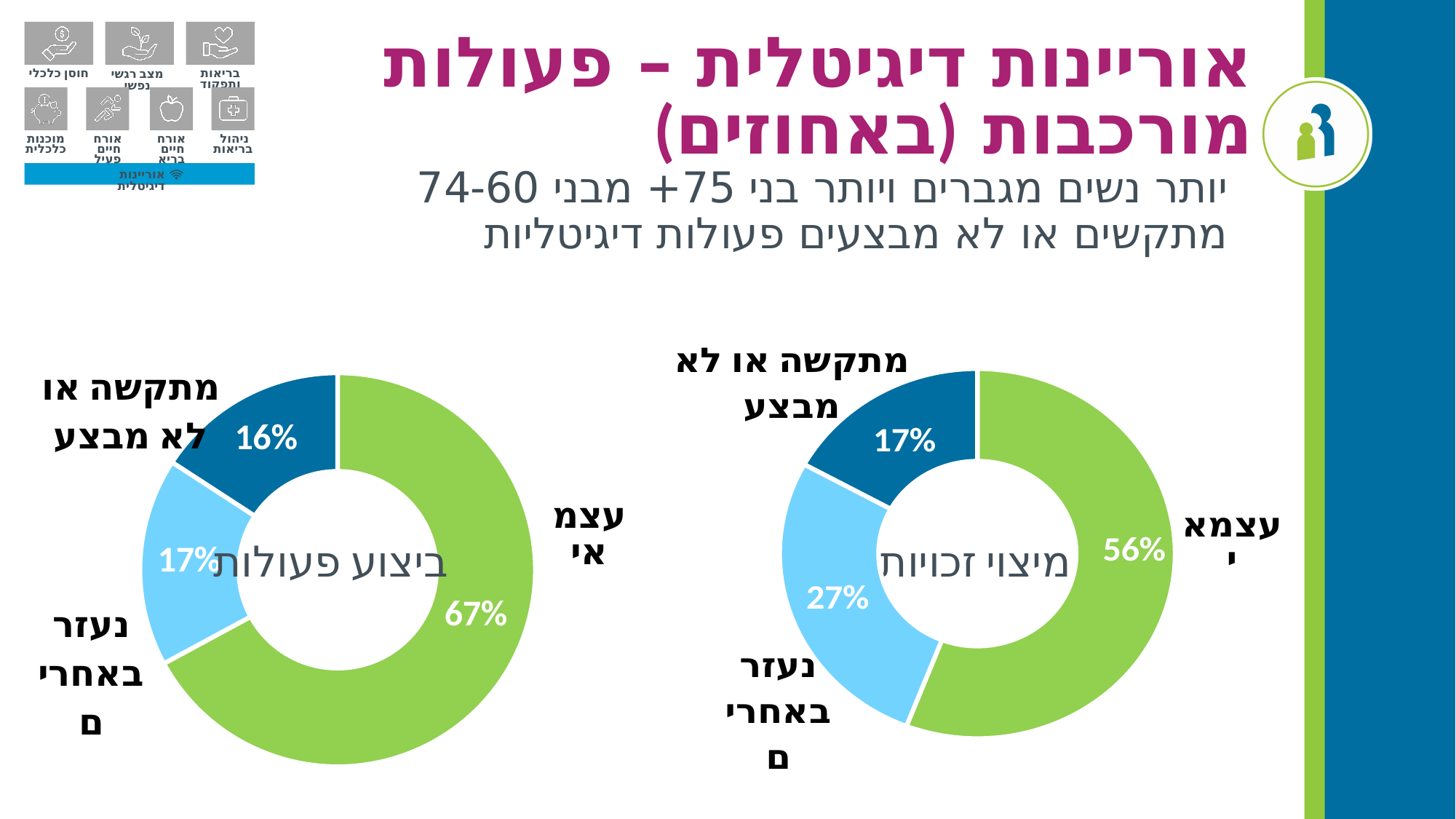
Which chart shows a larger share for "נעזר באחרים": the left chart (ביצוע פעולות) or the right chart (מיצוי זכויות)? מיצוי זכויות (right) How many slices does the chart titled "ביצוע פעולות" (left) have? 3 In the chart titled "מיצוי זכויות" (right), which category has the largest share? עצמאי What is the difference between the "עצמאי" share in the left chart (ביצוע פעולות) and the "עצמאי" share in the right chart (מיצוי זכויות)? 11 percentage points In the chart titled "מיצוי זכויות" (right), what is the difference between "נעזר באחרים" and "מתקשה או לא מבצע"? 10 percentage points In the chart titled "מיצוי זכויות" (right), what percentage is shown for "עצמאי"? 56% In the chart titled "ביצוע פעולות" (left), what percentage is shown for "מתקשה או לא מבצע"? 16% In the chart titled "מיצוי זכויות" (right), what percentage is shown for "נעזר באחרים"? 27% In the chart titled "ביצוע פעולות" (left), what percentage is shown for "עצמאי"? 67% What type of chart is the chart titled "מיצוי זכויות" (right)? Donut (pie) chart How many charts are shown on the slide? 2 In the chart titled "ביצוע פעולות" (left), which category has the smallest share? מתקשה או לא מבצע